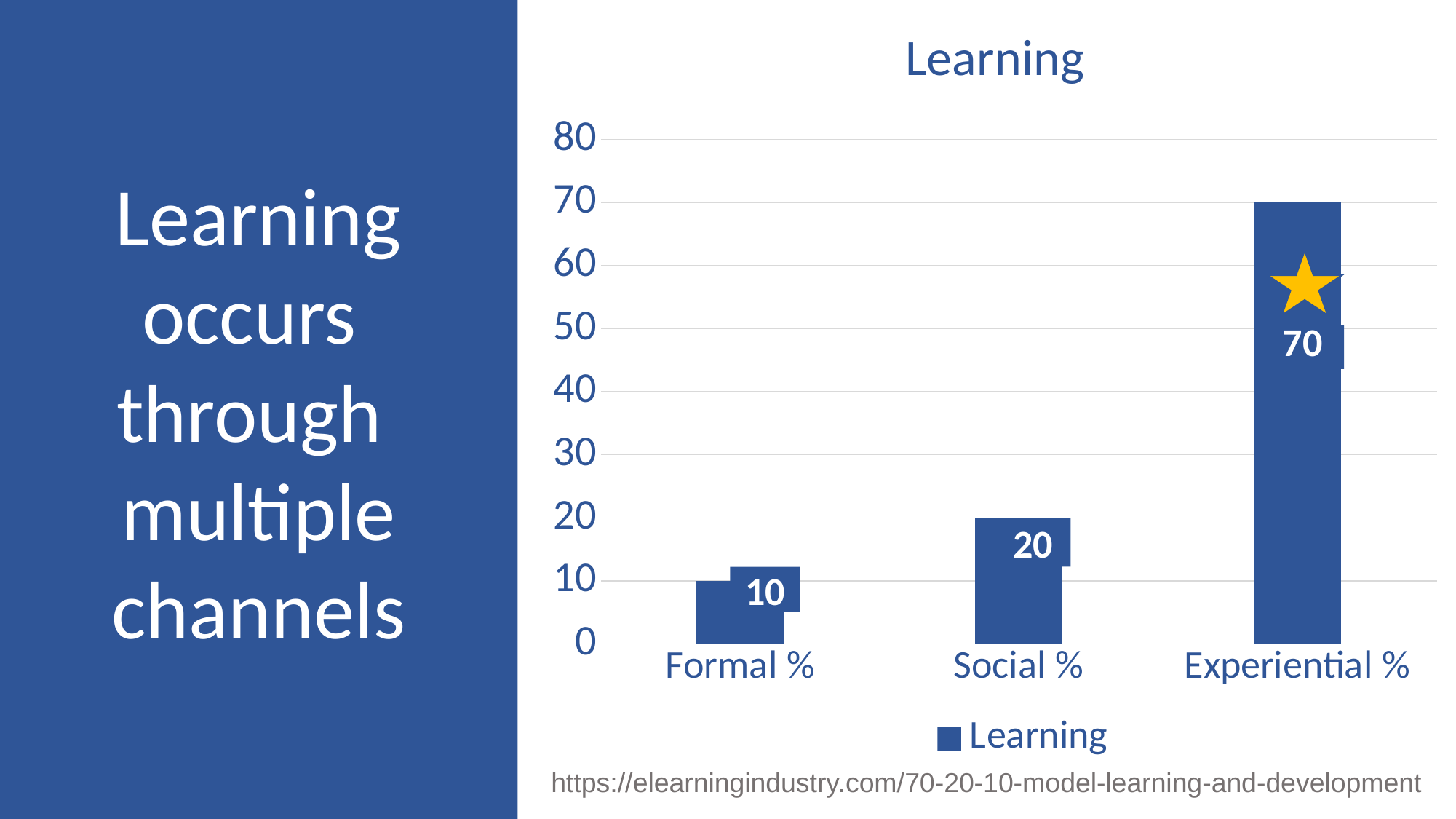
Which is larger, the value for Social % or the value for Formal %? Social % What is the value for Experiential %? 70 What is the value for Formal %? 10 What is the value for Social %? 20 Which category has the highest value? Experiential % Is the value for Experiential % greater or less than 60? greater How many categories are shown on the x axis? 3 What is the difference between the values for Experiential % and Social %? 50 What kind of chart is shown? bar chart What is the difference between the values for Social % and Formal %? 10 Which category has the lowest value? Formal % How many series does the legend list? 1